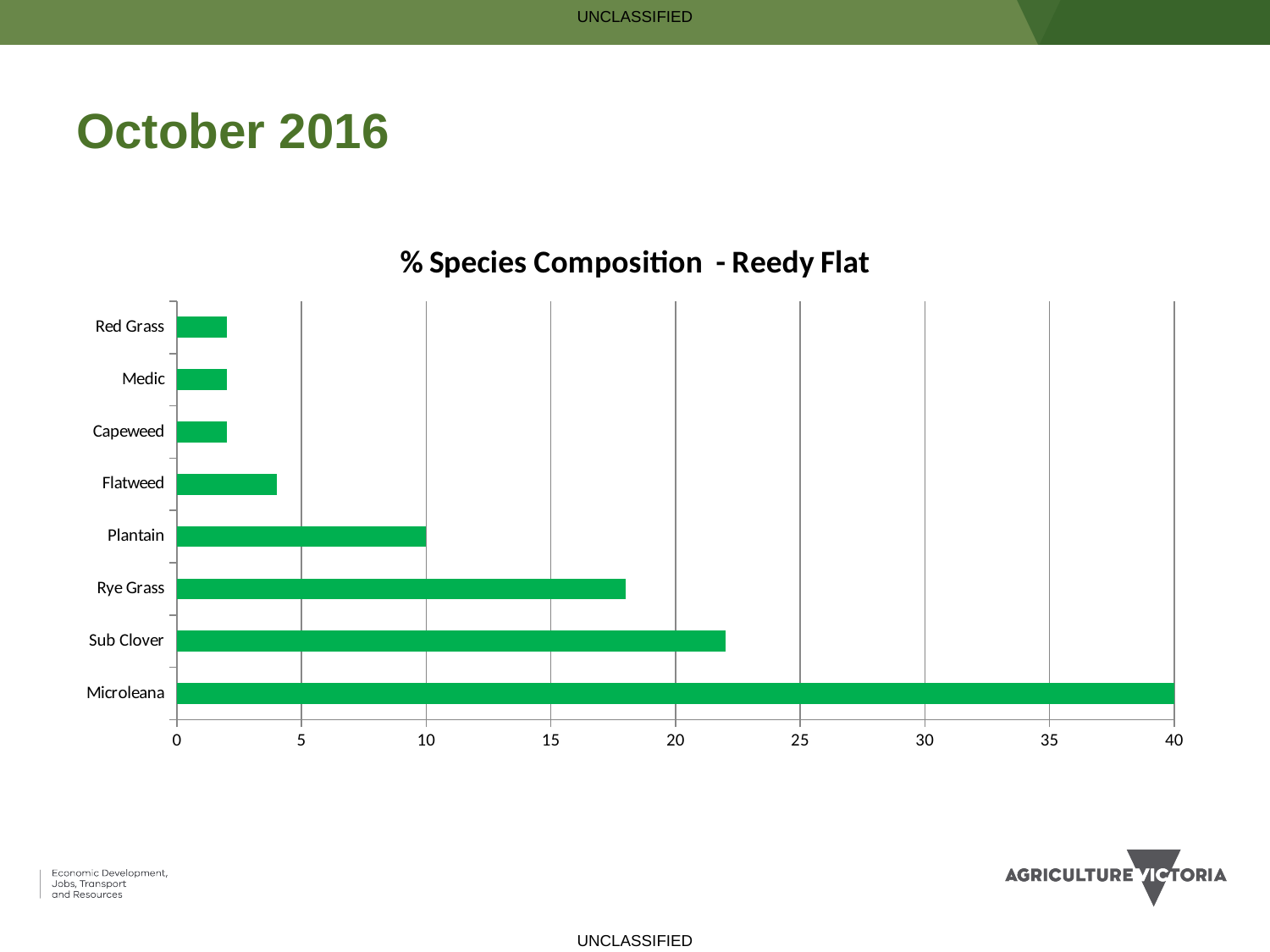
How many species categories are plotted in the chart? 8 Which has the larger value, Sub Clover or Rye Grass? Sub Clover Is the value for Flatweed greater or less than 5? less Which species has the highest value in the chart? Microleana Which has the larger value, Flatweed or Capeweed? Flatweed Is the value for Rye Grass greater or less than 20? less What is the value for Plantain? 10 What is the value for Microleana? 40 Is the value for Sub Clover greater or less than 20? greater What is the highest value shown on the horizontal axis? 40 What kind of chart is shown on the slide? Bar chart What is the title of the chart? % Species Composition - Reedy Flat